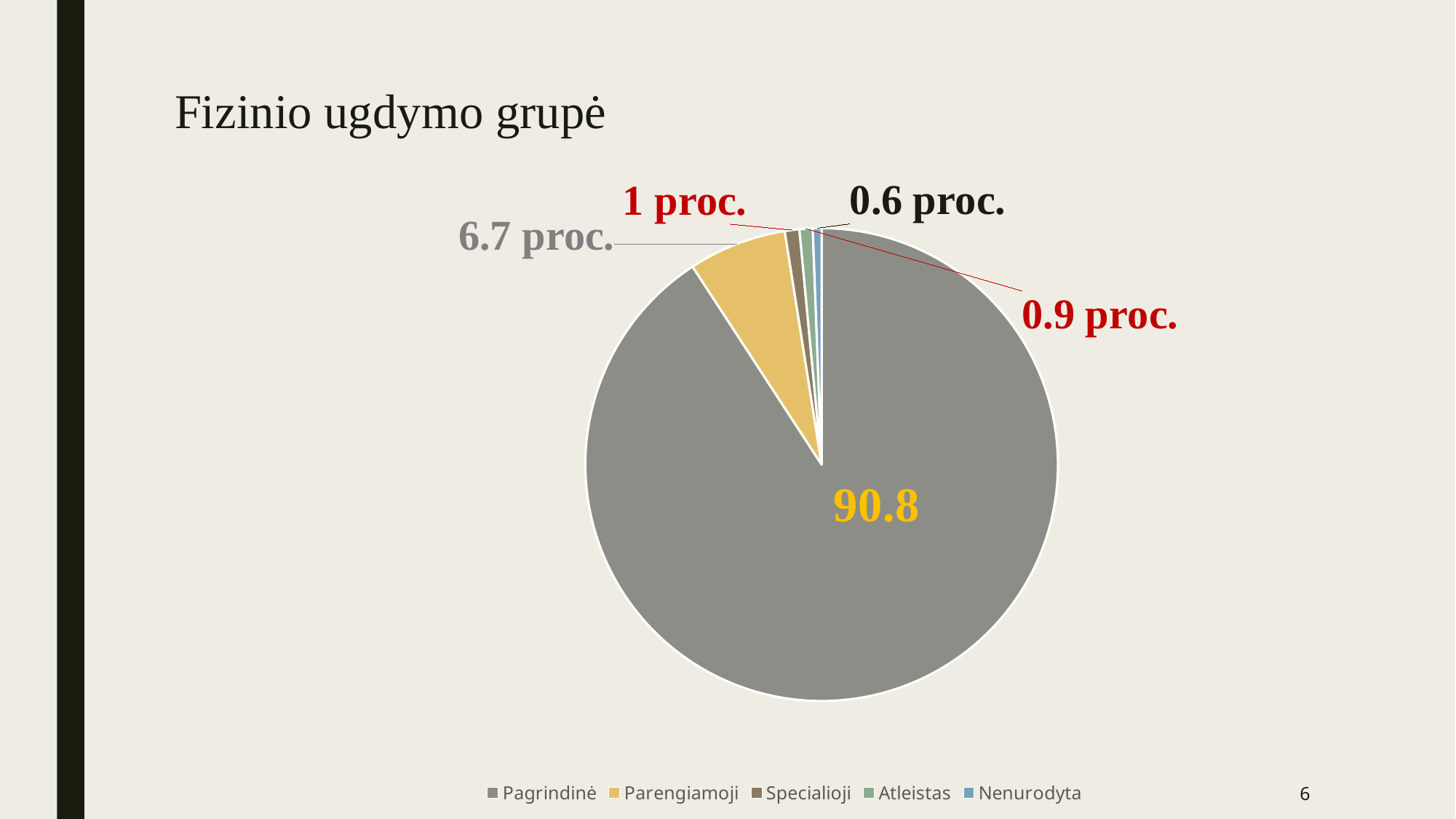
What is the smallest value labelled on the pie chart? 0.6 proc. Which is larger in the pie chart, Pagrindinė or Parengiamoji? Pagrindinė What share of the pie does the Pagrindinė slice represent? 90.8 What kind of chart is shown on the slide? pie chart What is the title of the slide with the pie chart? Fizinio ugdymo grupė What value is shown for the Pagrindinė slice of the pie chart? 90.8 Which category has the largest slice in the pie chart? Pagrindinė How many categories does the legend of the pie chart list? 5 Is the value for Parengiamoji in the pie chart greater or less than 10? less What value is shown for the Parengiamoji slice of the pie chart? 6.7 proc. What colour is the Parengiamoji slice in the pie chart? yellow What is the difference between the Pagrindinė value (90.8) and the Parengiamoji value (6.7) in the pie chart? 84.1